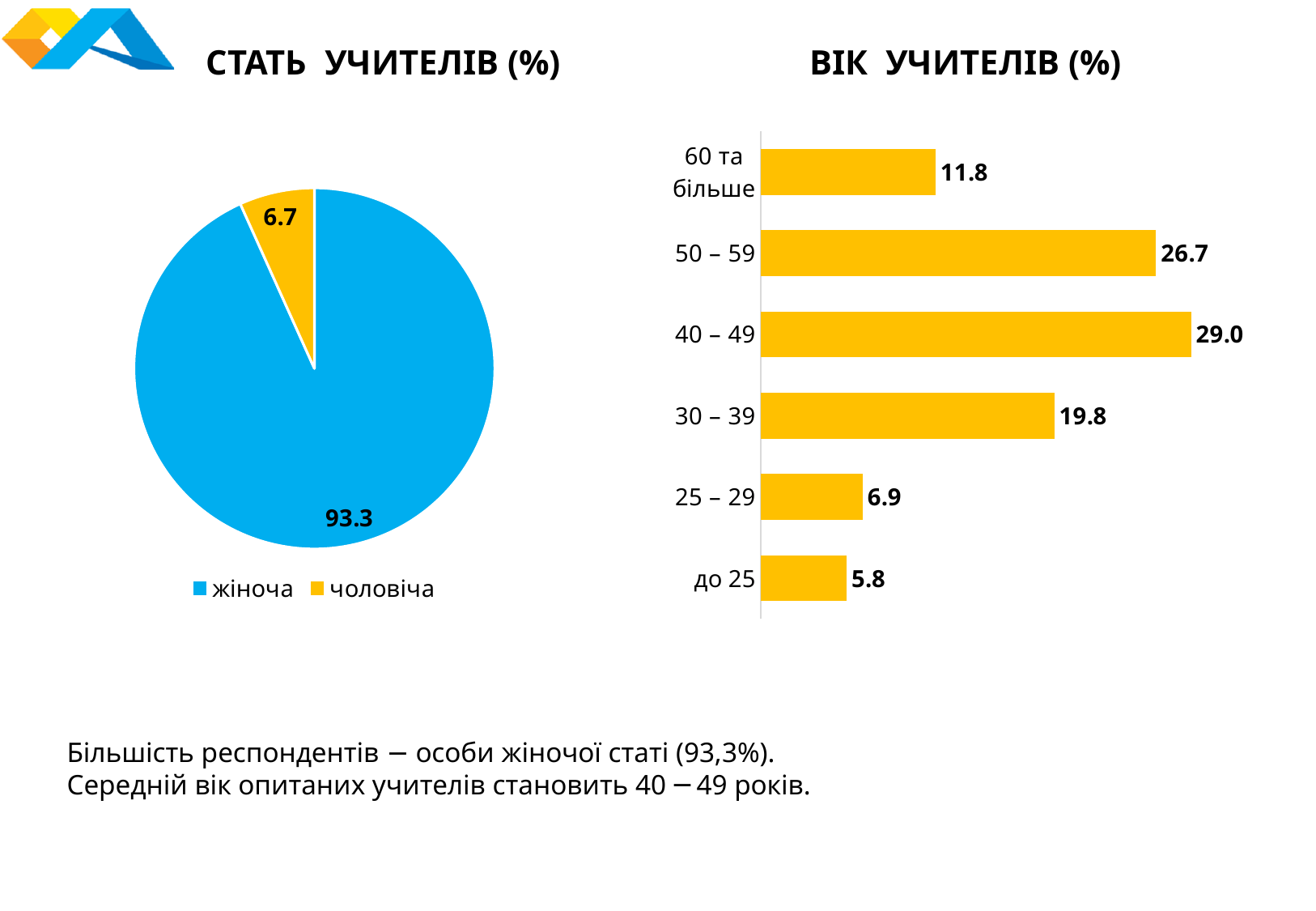
In the 'ВІК УЧИТЕЛІВ (%)' chart, which age group has the highest value? 40 – 49 In the 'СТАТЬ УЧИТЕЛІВ (%)' chart, what is the value for чоловіча? 6.7 In the 'ВІК УЧИТЕЛІВ (%)' chart, what is the value for 40 – 49? 29.0 What kind of chart is 'СТАТЬ УЧИТЕЛІВ (%)'? pie chart In the 'СТАТЬ УЧИТЕЛІВ (%)' chart, what is the value for жіноча? 93.3 In the 'ВІК УЧИТЕЛІВ (%)' chart, what is the value for до 25? 5.8 In the 'СТАТЬ УЧИТЕЛІВ (%)' chart, how many entries does the legend list? 2 What kind of chart is 'ВІК УЧИТЕЛІВ (%)'? bar chart In the 'ВІК УЧИТЕЛІВ (%)' chart, what is the difference between the values for 50 – 59 and 30 – 39? 6.9 In the 'ВІК УЧИТЕЛІВ (%)' chart, how many age categories are shown? 6 In the 'СТАТЬ УЧИТЕЛІВ (%)' chart, what is the difference between the жіноча and чоловіча values? 86.6 In the 'ВІК УЧИТЕЛІВ (%)' chart, which age group has the lowest value? до 25